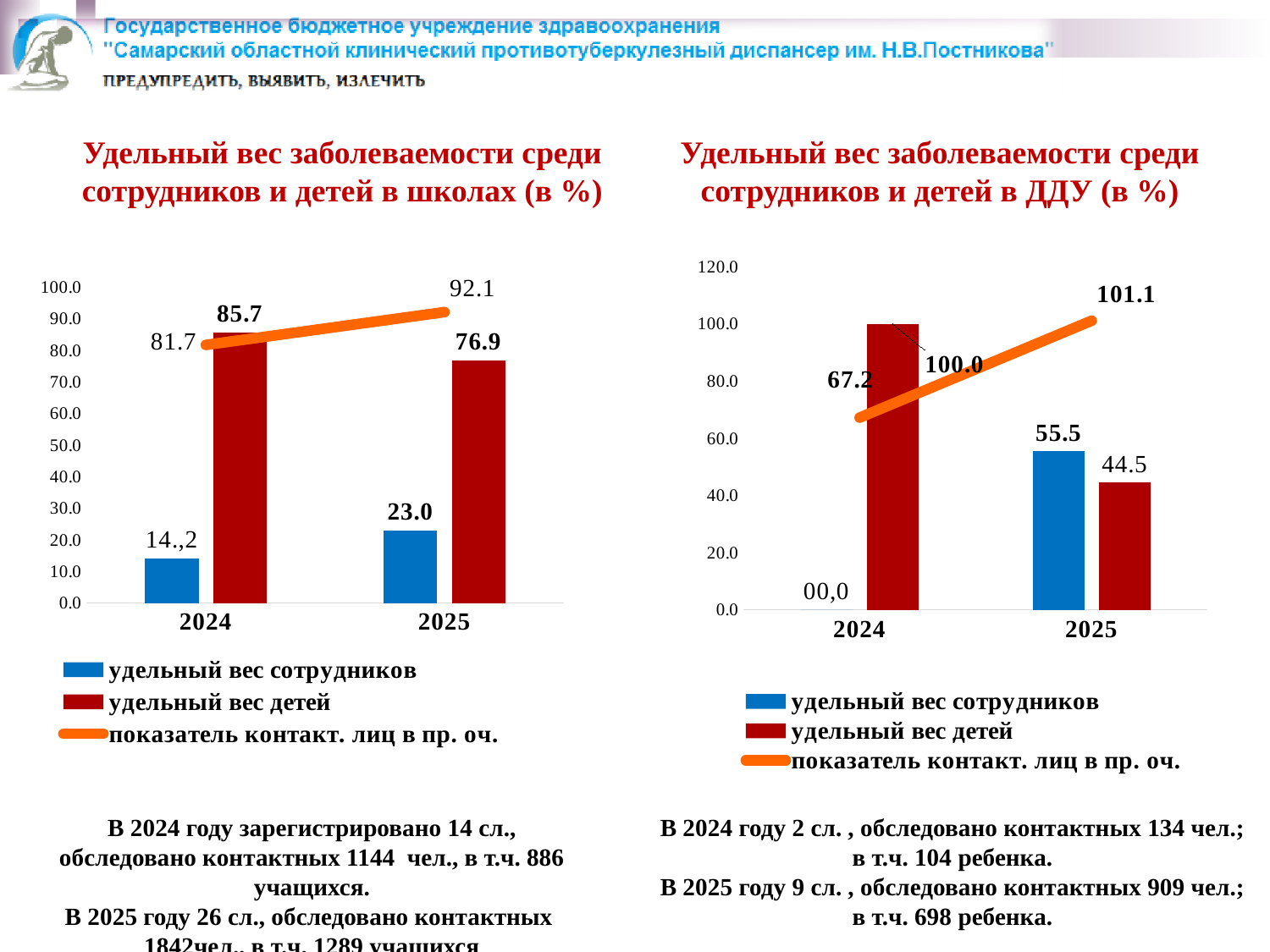
In the left chart (schools), does 'показатель контакт. лиц в пр. оч.' rise or fall from 2024 to 2025? rise In the left chart (schools), what is the value of 'удельный вес детей' for 2024? 85.7 In the left chart (schools), what is the value of 'удельный вес сотрудников' for 2025? 23.0 In the right chart (ДДУ), what is the value of 'удельный вес детей' for 2024? 100.0 In the left chart (schools), by how much did 'удельный вес детей' change from 2024 to 2025? 8.8 In the left chart (schools), what is the value of 'показатель контакт. лиц в пр. оч.' for 2025? 92.1 How many years are shown on the x axis of the left chart (schools)? 2 In the right chart (ДДУ), what is the value of 'удельный вес сотрудников' for 2025? 55.5 In the right chart (ДДУ), what is the value of 'показатель контакт. лиц в пр. оч.' for 2024? 67.2 In the right chart (ДДУ), which is larger in 2025: 'удельный вес сотрудников' or 'удельный вес детей'? удельный вес сотрудников How many series does the legend of the right chart (ДДУ) list? 3 In the right chart (ДДУ), what is the difference between 'удельный вес детей' in 2024 and 2025? 55.5